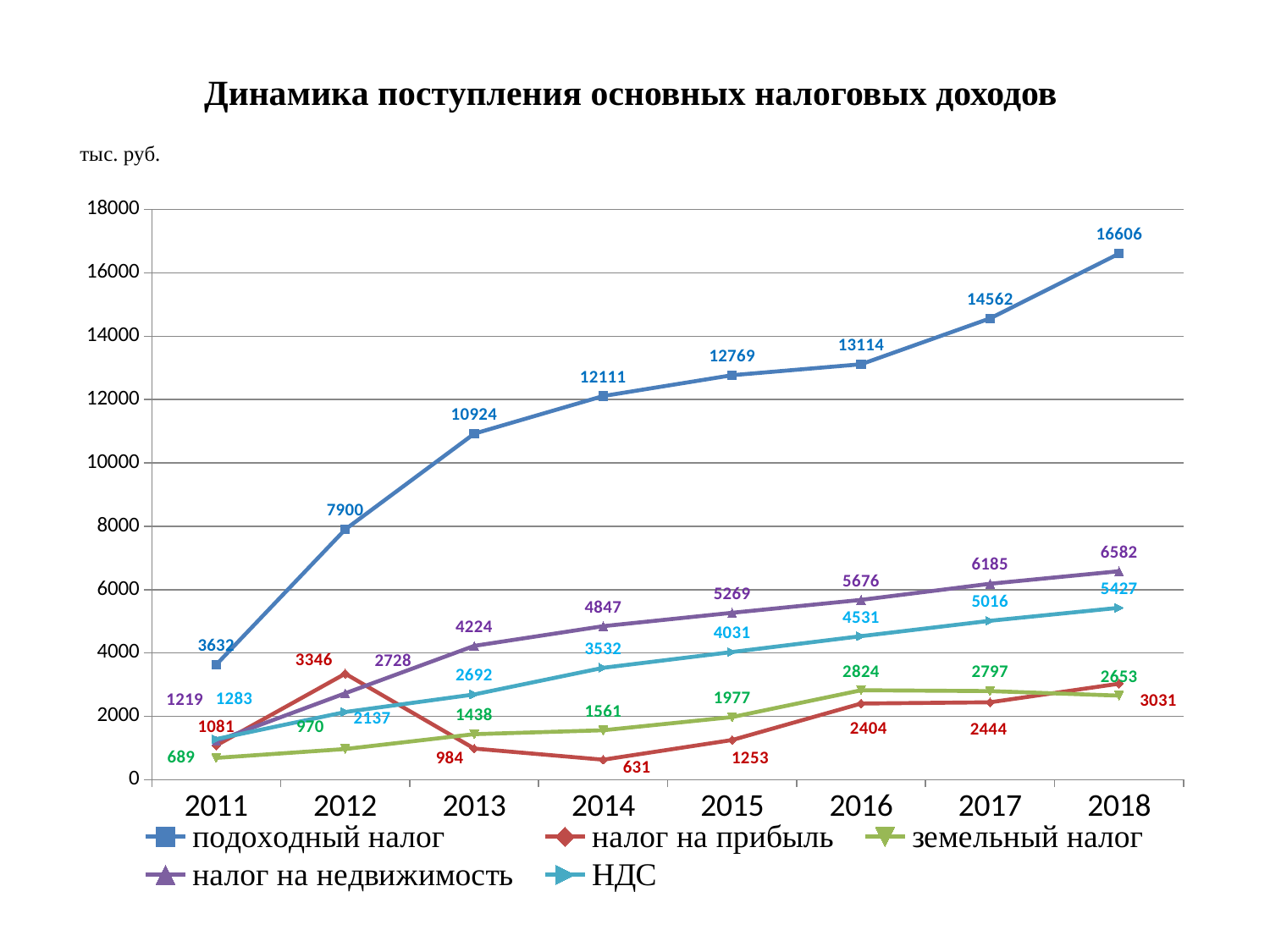
How many series does the legend list? 5 How many years are shown on the x axis? 8 In which year is налог на прибыль at its lowest? 2014 What is the difference between подоходный налог in 2018 and in 2017? 2044 What is the value of подоходный налог in 2018? 16606 What unit is indicated above the chart? тыс. руб. In which year is земельный налог at its highest? 2016 What kind of chart is this? line chart Does подоходный налог rise or fall from 2011 to 2018? rise Which is larger in 2012: налог на прибыль or налог на недвижимость? налог на прибыль What is the value of налог на недвижимость in 2013? 4224 What is the value of НДС in 2015? 4031